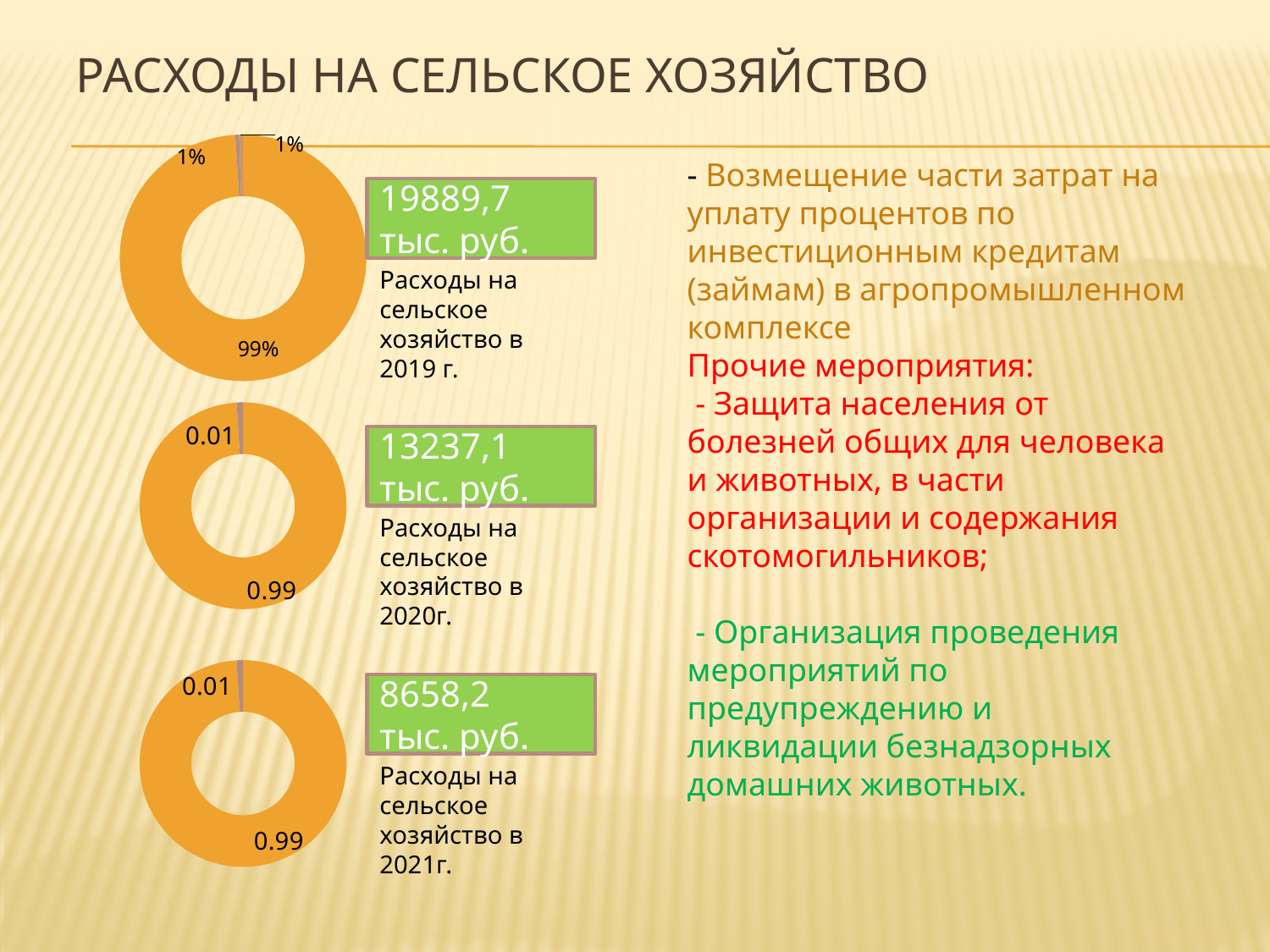
What kind of chart is the top chart on the slide (for 2019)? Doughnut (pie) chart In the middle chart (2020), what is the value of the largest slice? 0.99 In the bottom chart (2021), what is the value of the largest slice? 0.99 What total amount is shown in the green box next to the top chart (2019)? 19889,7 тыс. руб. How many slices are labelled in the top chart (2019)? 3 In the bottom chart (2021), what is the value of the small slice? 0.01 What total amount is shown in the green box next to the bottom chart (2021)? 8658,2 тыс. руб. In the bottom chart (2021), which slice is larger: the one labelled 0.99 or the one labelled 0.01? 0.99 How many slices are labelled in the middle chart (2020)? 2 In the top chart (2019), what is the value shown for the largest slice? 99% In the middle chart (2020), what is the value of the small slice? 0.01 In the top chart (2019), what value is shown for each of the two small slices? 1%